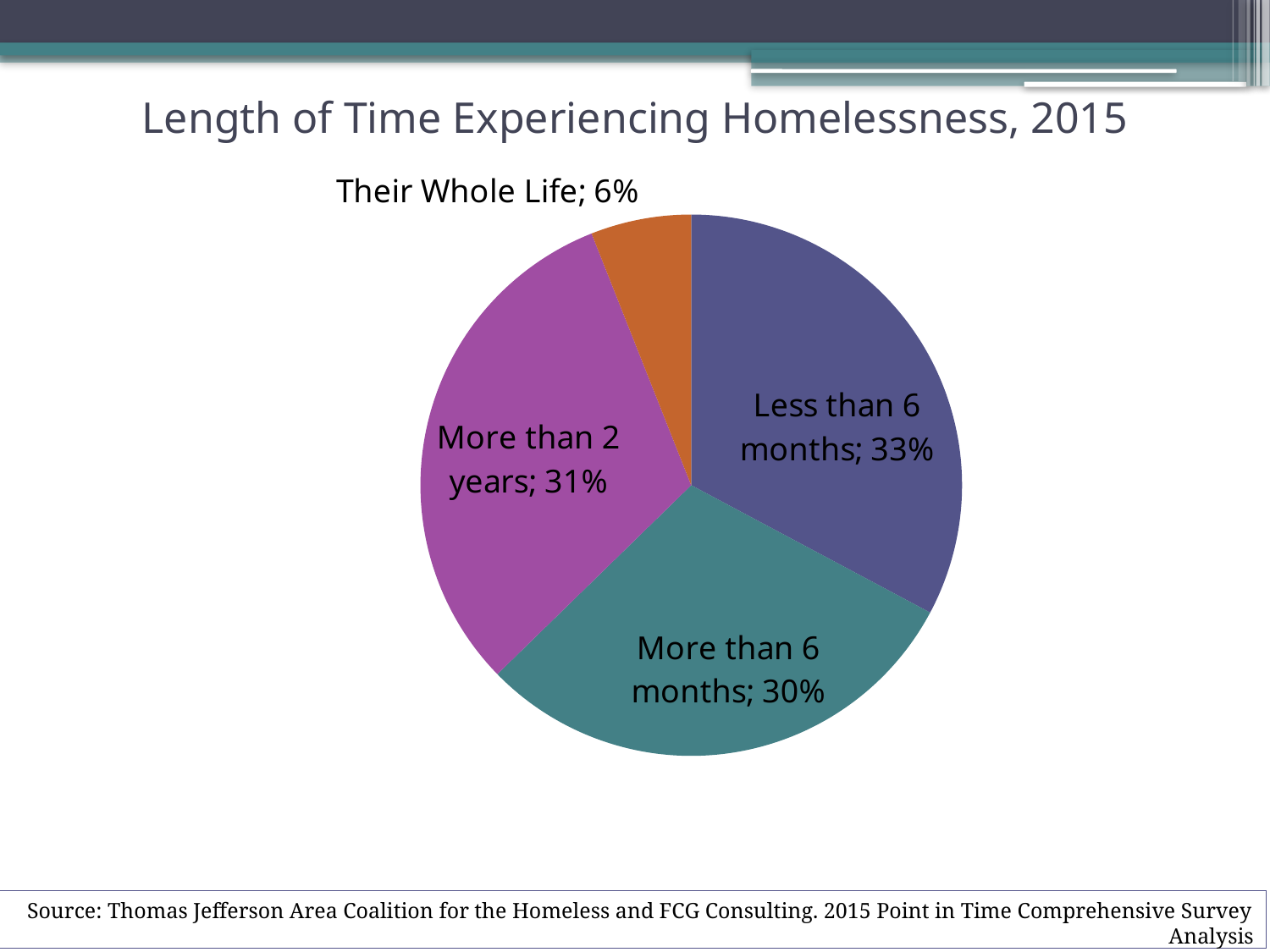
What is the title of the chart? Length of Time Experiencing Homelessness, 2015 Which category has the largest slice of the pie? Less than 6 months What share of the pie is labelled 'More than 2 years'? 31% What is the difference in percentage points between 'More than 2 years' and 'More than 6 months'? 1 How many slices does the pie chart have? 4 What kind of chart is shown on the slide? pie chart Which is larger, the share for 'Less than 6 months' or the share for 'More than 6 months'? Less than 6 months What share of the pie is labelled 'Less than 6 months'? 33% What share of the pie is labelled 'Their Whole Life'? 6% Which category has the smallest slice of the pie? Their Whole Life What is the difference in percentage points between 'Less than 6 months' and 'Their Whole Life'? 27